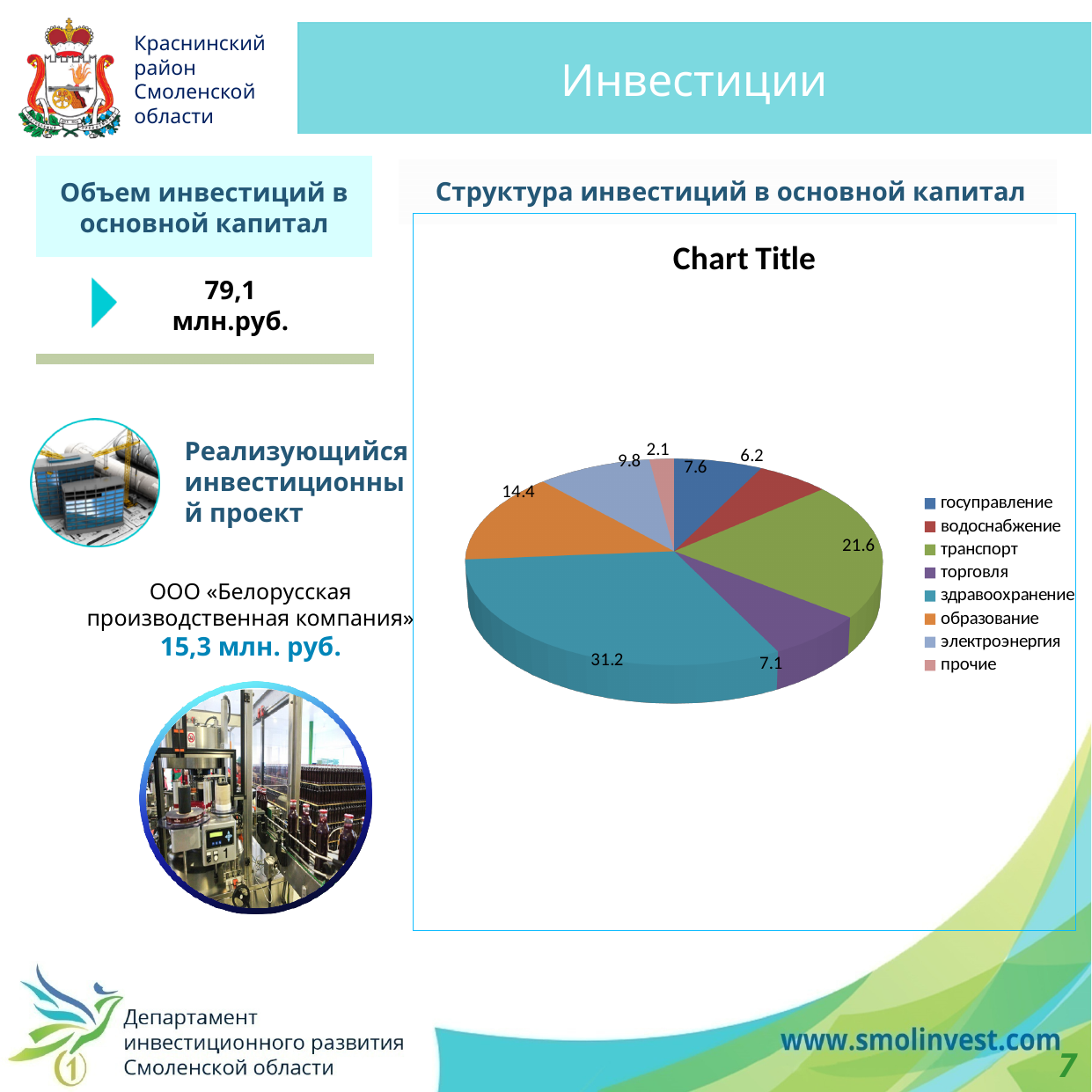
What is the value shown for образование in the pie chart? 14.4 What is the value shown for здравоохранение in the pie chart? 31.2 Which category has the smallest slice in the pie chart? прочие What is the value shown for транспорт in the pie chart? 21.6 What is the value shown for электроэнергия in the pie chart? 9.8 What is the difference between the values for здравоохранение and транспорт in the pie chart? 9.6 What kind of chart is shown under the heading "Структура инвестиций в основной капитал"? pie chart What colour is the slice for образование in the pie chart? orange What is the title printed above the pie chart? Chart Title Which is larger in the pie chart, госуправление or водоснабжение? госуправление How many categories does the pie chart's legend list? 8 Which category has the largest slice in the pie chart? здравоохранение